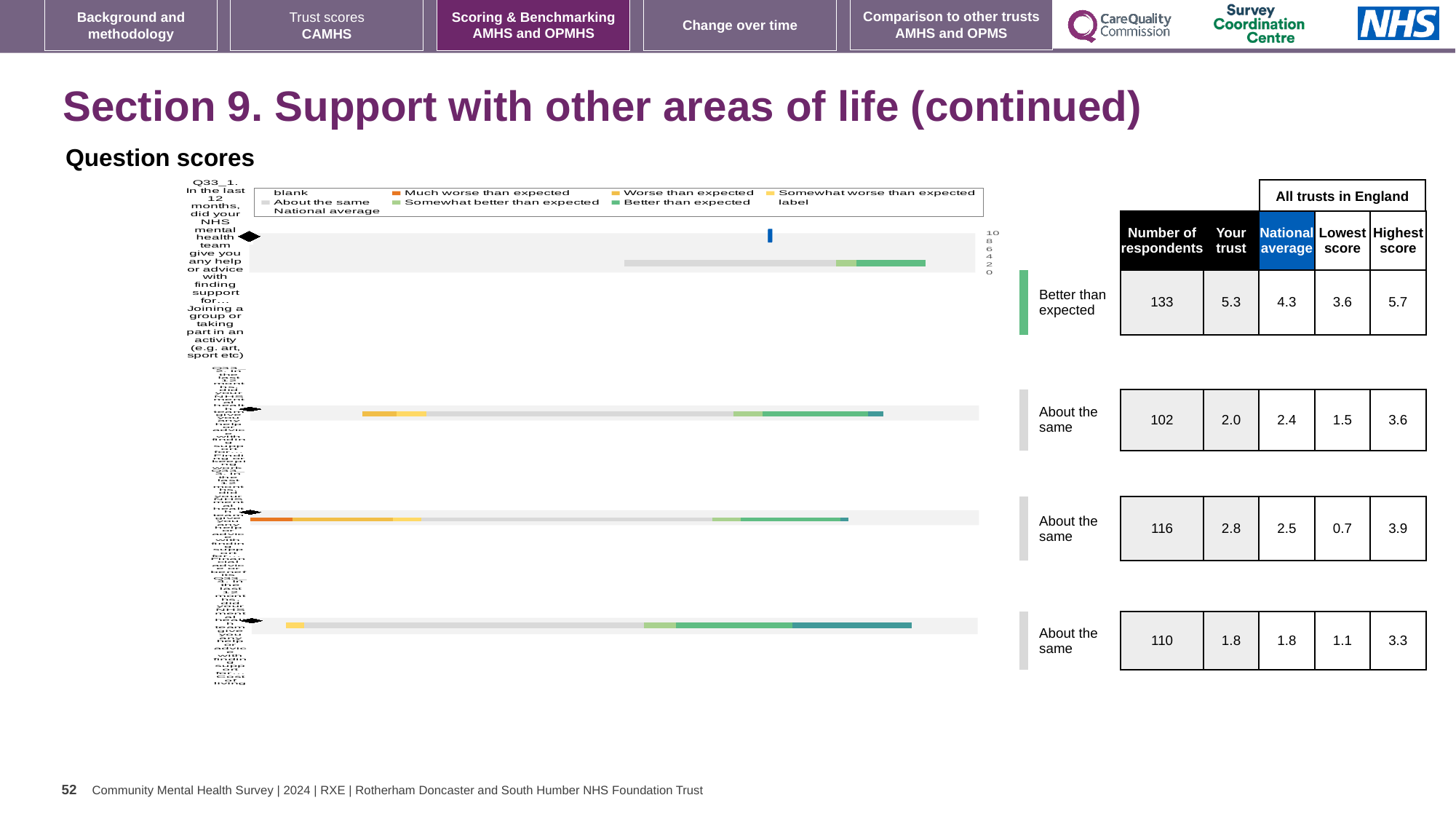
According to the table beside the chart, what is the 'Your trust' score for the first bar (Q33_1, joining a group or taking part in an activity)? 5.3 Which benchmark category label is shown next to the first (top) bar of the question scores chart? Better than expected What is the question number of the first (top) bar in the question scores chart? Q33_1 According to the table beside the chart, what is the national average for the first bar (Q33_1)? 4.3 What kind of chart is shown under 'Question scores'? bar chart What is the highest tick value shown on the axis of the question scores chart? 10 How many entries does the legend of the question scores chart list? 9 How many bars are plotted in the question scores chart? 4 In the question scores chart legend, which entry is shown in orange-red? Much worse than expected According to the table beside the chart, what is the number of respondents for the first bar (Q33_1)? 133